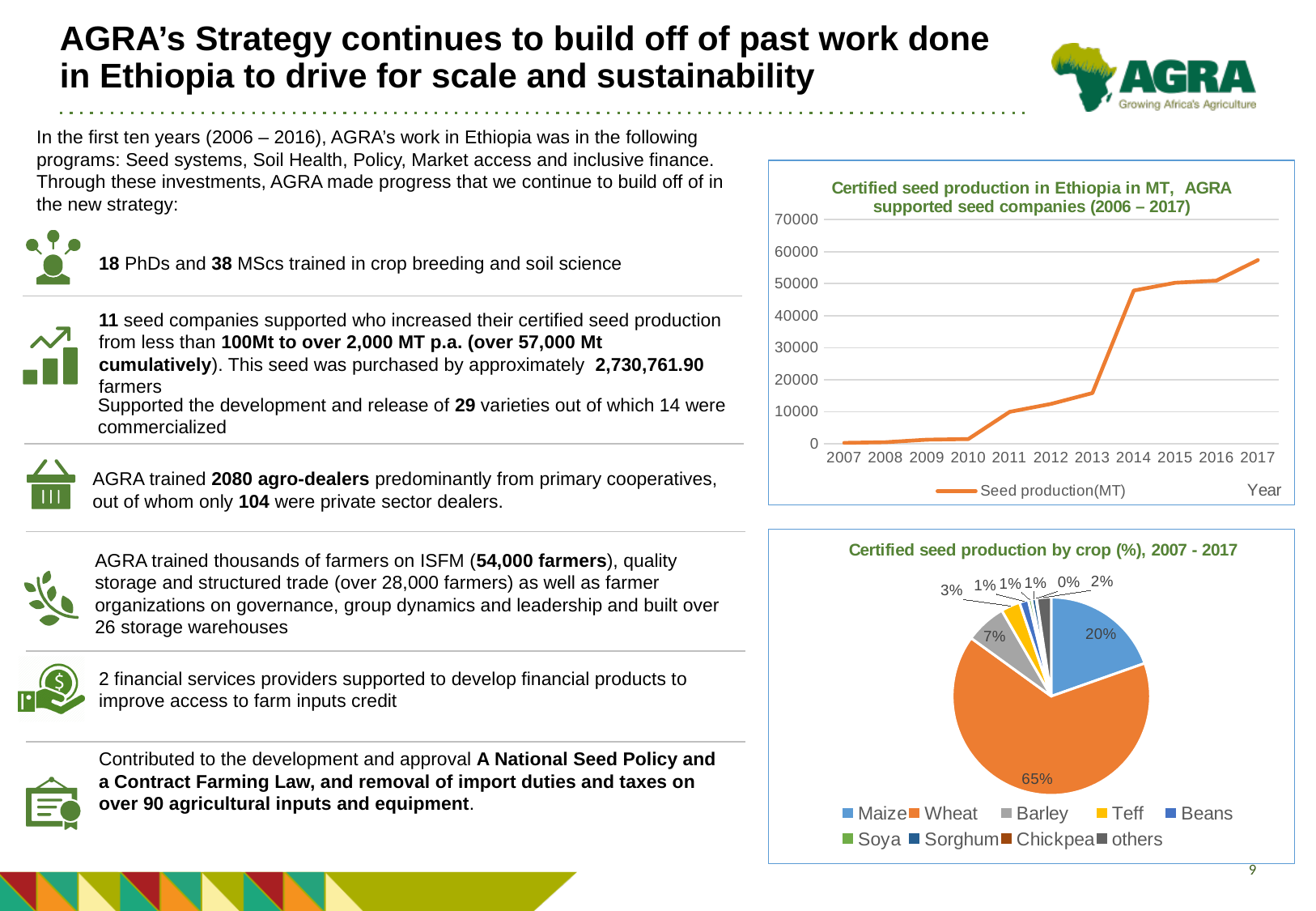
How many series does the legend of the 'Certified seed production in Ethiopia in MT' chart list? 1 How many years are shown on the x axis of the 'Certified seed production in Ethiopia in MT' chart? 11 In the 'Certified seed production in Ethiopia in MT' chart, do the values generally rise or fall from 2007 to 2017? rise What kind of chart is the 'Certified seed production by crop (%), 2007 - 2017' chart? pie chart In the 'Certified seed production in Ethiopia in MT' chart, is the value for 2013 greater or less than 20000? less What kind of chart is the 'Certified seed production in Ethiopia in MT' chart? line chart In the 'Certified seed production in Ethiopia in MT' chart, is the value for 2010 greater or less than 10000? less In the 'Certified seed production by crop (%)' chart, which crop has the largest share? Wheat How many crop categories does the legend of the 'Certified seed production by crop (%)' chart list? 9 In the 'Certified seed production by crop (%)' chart, what is the difference between the Wheat share and the Maize share? 45% In the 'Certified seed production by crop (%)' chart, what share does Wheat have? 65% In the 'Certified seed production in Ethiopia in MT' chart, is the value for 2017 greater or less than 50000? greater